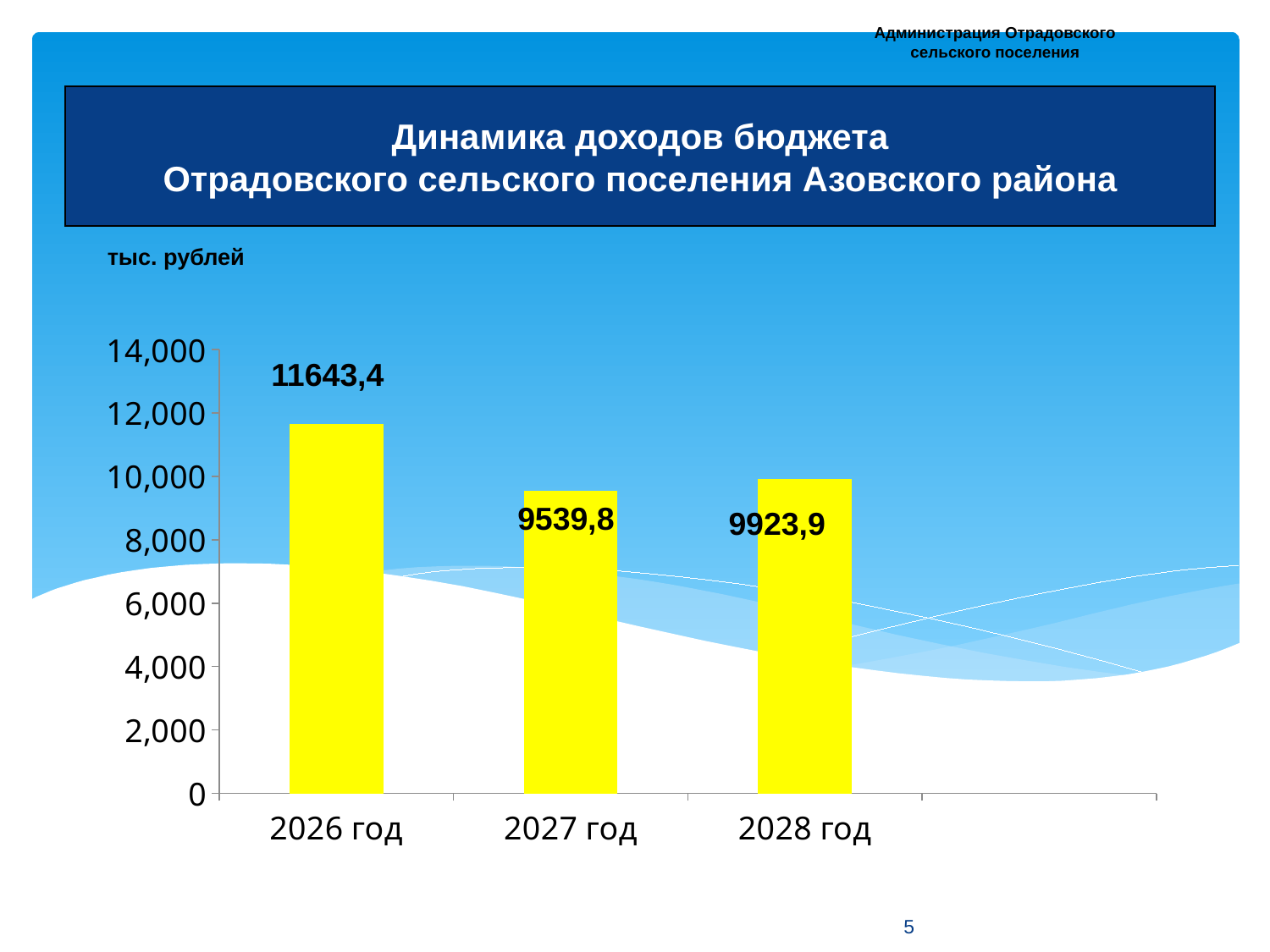
Which is larger, the value for 2028 год or the value for 2027 год? 2028 год Which year has the highest value? 2026 год Does the value rise or fall from 2026 год to 2027 год? fall What kind of chart is shown on the slide? bar chart What is the difference between the values for 2028 год and 2027 год? 384,1 Is the value for 2026 год greater or less than 10,000? greater How many years are shown on the chart? 3 What is the value for 2028 год? 9923,9 What is the value for 2027 год? 9539,8 What is the difference between the values for 2026 год and 2027 год? 2103,6 What is the value for 2026 год? 11643,4 Which year has the lowest value? 2027 год